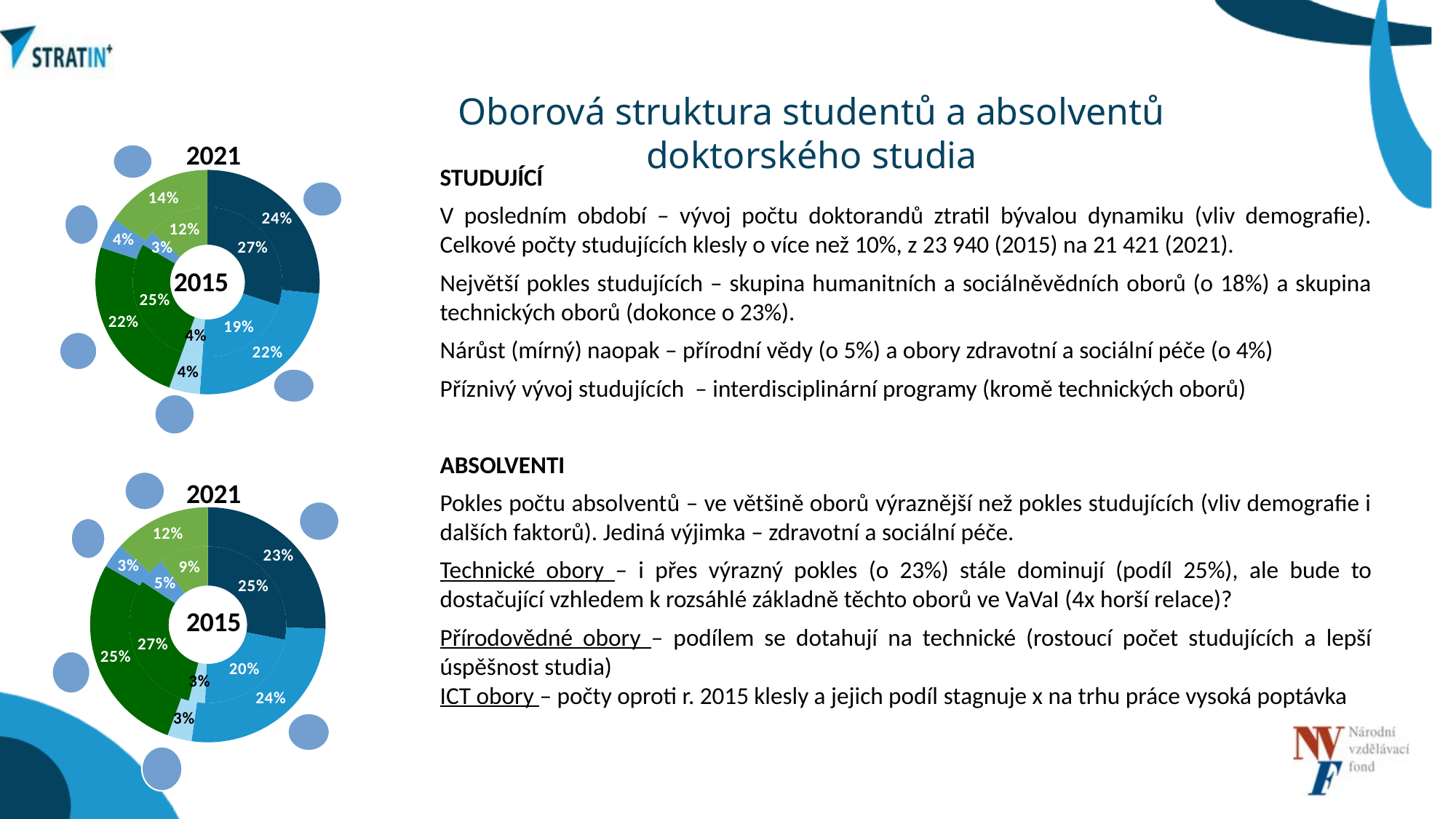
How many rings (years) does the bottom chart show? 2 In the bottom chart, what is the smallest share labelled in the outer 2021 ring? 3% In the bottom chart, what is the difference between the largest inner-ring share (27%) and the largest outer-ring share (25%)? 2% In the bottom chart, what is the largest share shown in the outer 2021 ring? 25% In the top chart, which year does the inner ring represent? 2015 In the top chart, what is the largest share shown in the outer 2021 ring? 24% What kind of chart is the top chart on the slide? doughnut (pie) chart In the top chart, is the largest slice of the inner 2015 ring (27%) greater or less than the largest slice of the outer 2021 ring (24%)? greater In the top chart, what is the smallest share labelled in the inner 2015 ring? 3% In the top chart, which year does the outer ring represent? 2021 In the bottom chart, what is the largest share shown in the inner 2015 ring? 27%